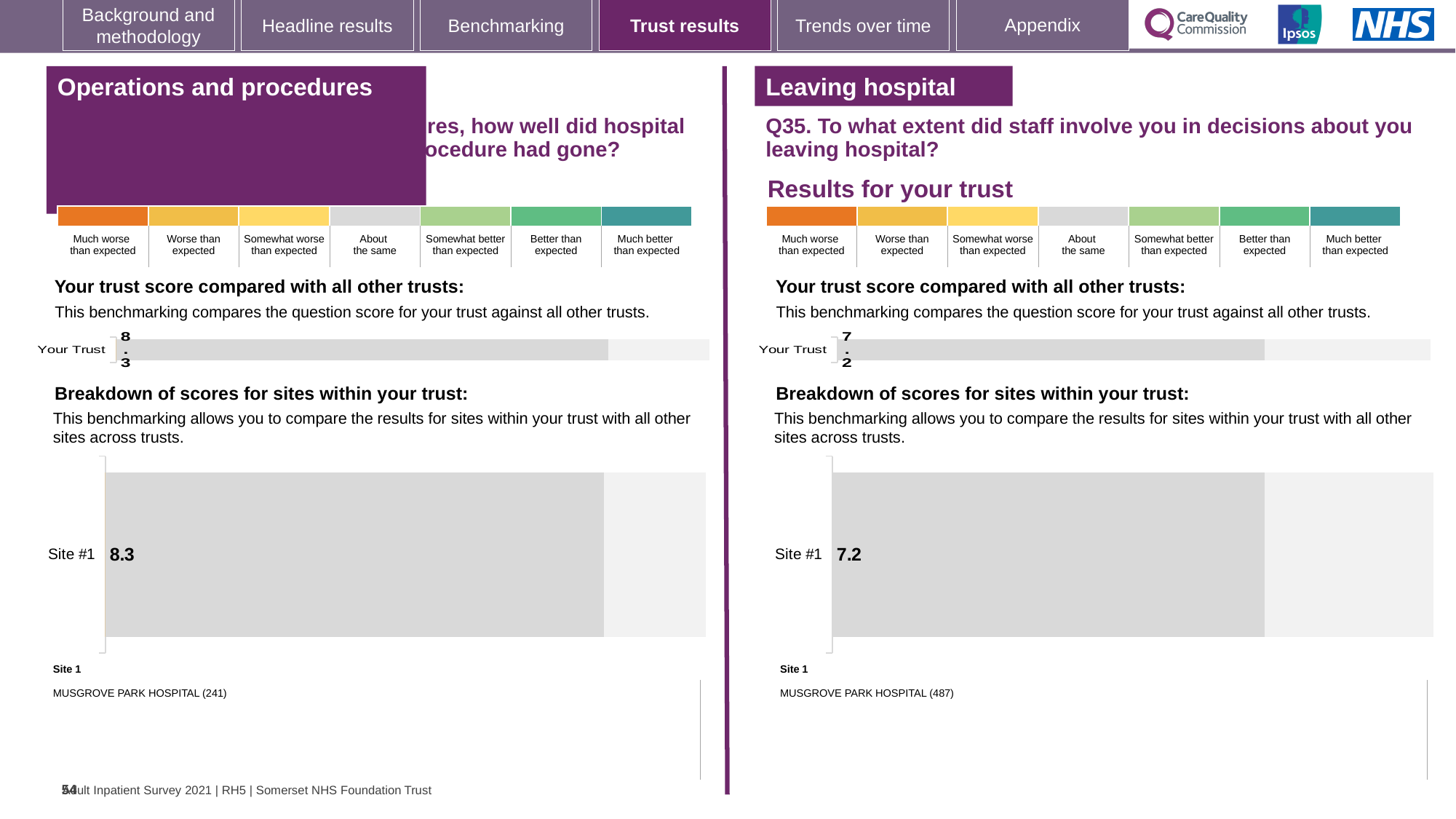
How many sites are shown in the site breakdown chart of the 'Leaving hospital' section? 1 On the right-hand 'Leaving hospital' section, what is the 'Your Trust' score in the trust benchmarking chart? 7.2 On the left-hand 'Operations and procedures' section, what is the 'Your Trust' score in the trust benchmarking chart? 8.3 How many sites are shown in the site breakdown chart of the 'Operations and procedures' section? 1 What is the question number shown in the 'Leaving hospital' section? Q35 In the 'Leaving hospital' section, which hospital is listed as Site 1? MUSGROVE PARK HOSPITAL (487) What is the difference between the Site #1 score in the 'Operations and procedures' section and the Site #1 score in the 'Leaving hospital' section? 1.1 Which Site #1 score is higher: the one in the 'Operations and procedures' section or the one in the 'Leaving hospital' section? Operations and procedures On the right-hand 'Leaving hospital' section, what is the score shown for Site #1? 7.2 On the left-hand 'Operations and procedures' section, what is the score shown for Site #1? 8.3 In the 'Operations and procedures' section, which hospital is listed as Site 1? MUSGROVE PARK HOSPITAL (241) What type of chart is used to show the Site #1 score in the 'Leaving hospital' section? Bar chart